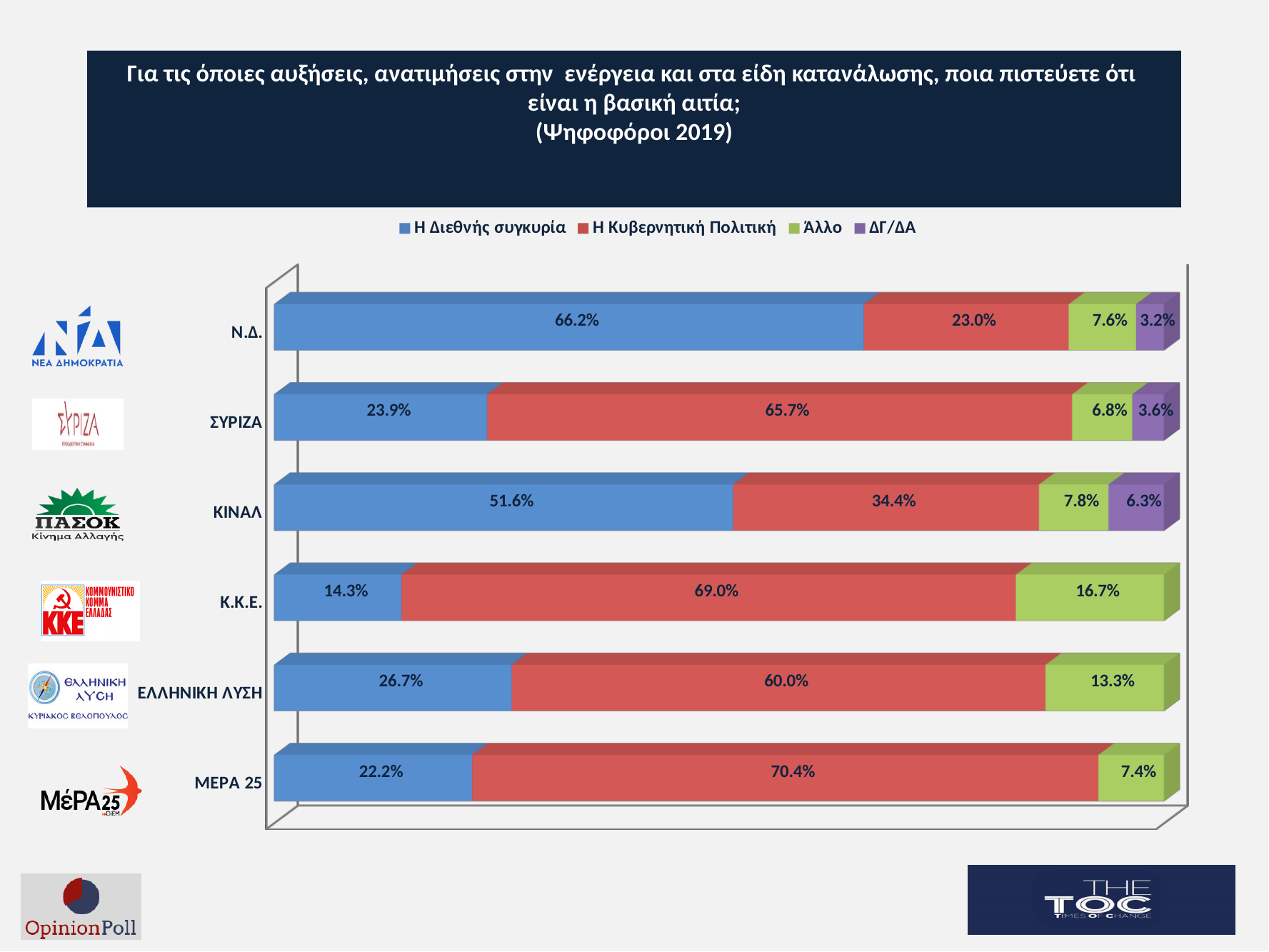
Which party's voters have the highest value for Η Κυβερνητική Πολιτική? ΜΕΡΑ 25 What is the value for Η Κυβερνητική Πολιτική among ΣΥΡΙΖΑ voters? 65.7% How many series does the legend list? 4 Which party's voters have the lowest value for Η Διεθνής συγκυρία? Κ.Κ.Ε. Which is larger: the Η Κυβερνητική Πολιτική value for ΕΛΛΗΝΙΚΗ ΛΥΣΗ or for ΚΙΝΑΛ? ΕΛΛΗΝΙΚΗ ΛΥΣΗ What is the ΔΓ/ΔΑ value for ΚΙΝΑΛ voters? 6.3% What is the total of the Η Διεθνής συγκυρία and Η Κυβερνητική Πολιτική segments for ΜΕΡΑ 25 voters? 92.6% What kind of chart is shown on the slide? Stacked bar chart What is the difference between the Η Διεθνής συγκυρία values for Ν.Δ. and ΚΙΝΑΛ voters? 14.6% How many parties (categories) are shown in the chart? 6 What percentage of Ν.Δ. voters attribute the increases to Η Διεθνής συγκυρία? 66.2% What is the Άλλο value for Κ.Κ.Ε. voters? 16.7%